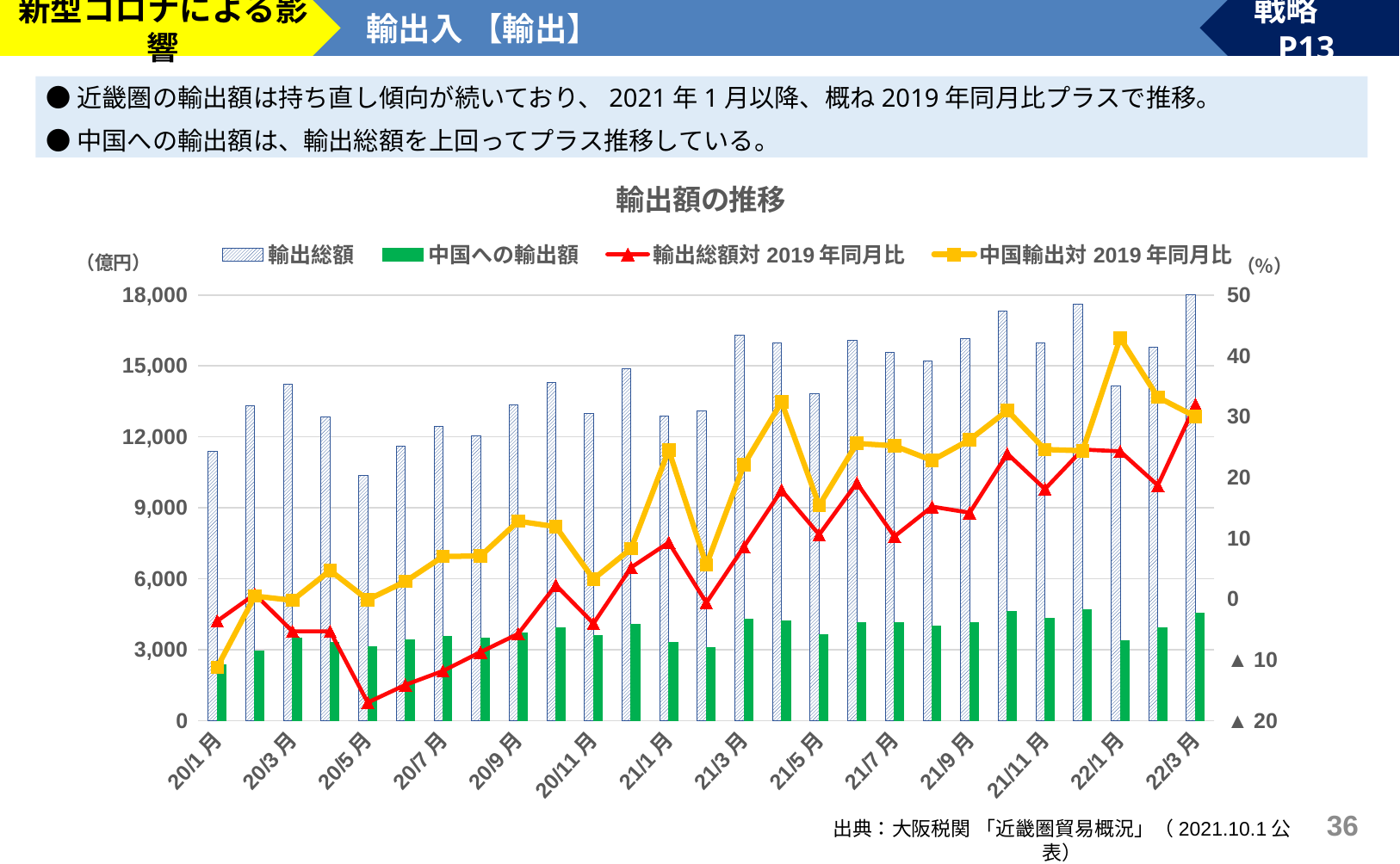
Is the value of 中国への輸出額 for 20/1月 greater or less than 3,000? less How many series does the legend list? 4 Which is larger, 輸出総額 for 20/5月 or 輸出総額 for 21/3月? 21/3月 What unit is shown on the left vertical axis? 億円 In which month is 輸出総額 lowest? 20/5月 How many months are plotted along the x axis? 27 Is the value of 輸出総額 for 22/3月 greater or less than 15,000? greater Is the value of 輸出総額 for 20/5月 greater or less than 12,000? less What is the title of the chart? 輸出額の推移 What kind of chart is shown on the slide? A combination bar and line chart In which month does 中国輸出対2019年同月比 reach its highest value? 22/1月 In which month is 中国への輸出額 lowest? 20/1月